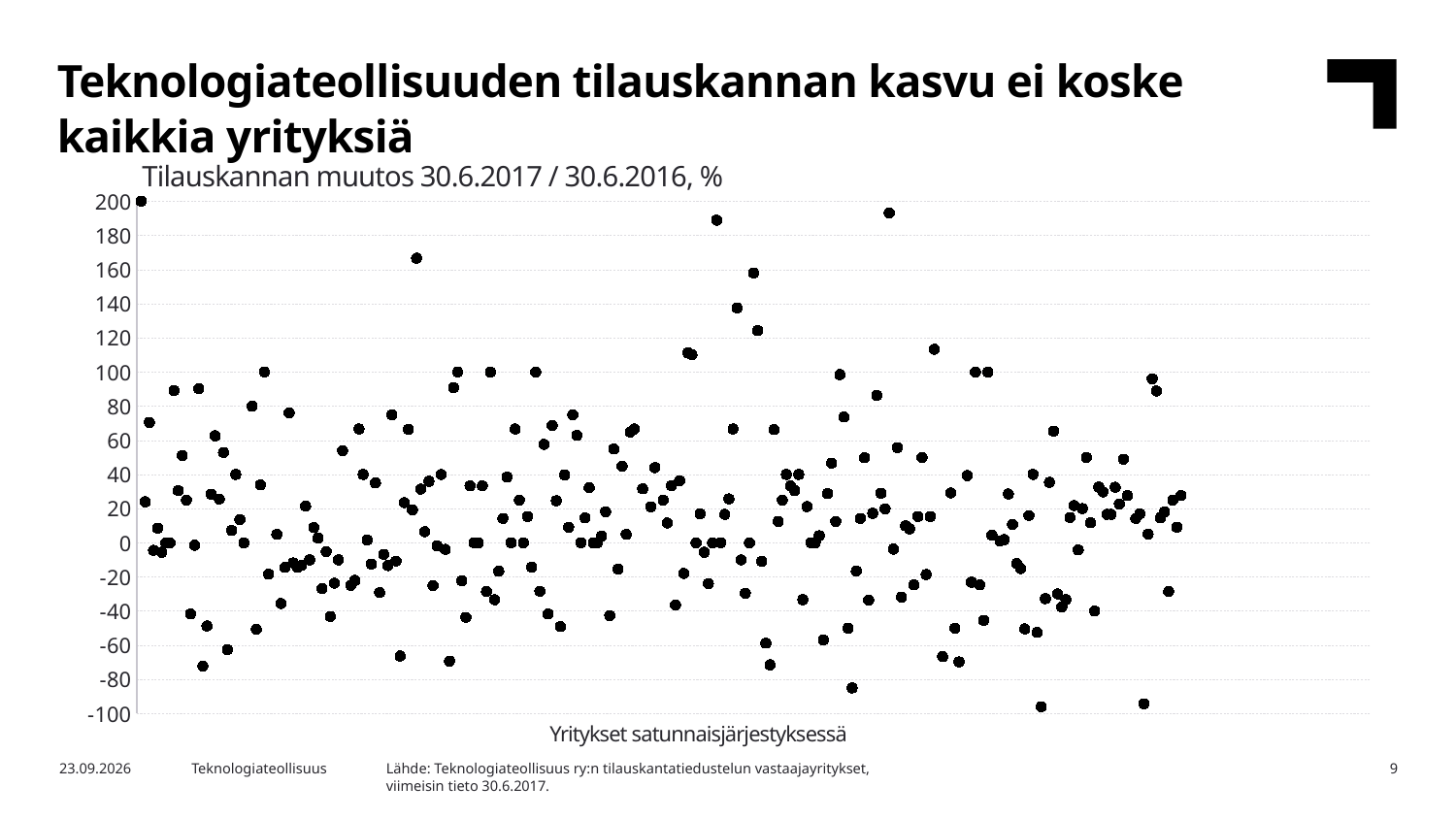
Is the highest plotted point on the chart greater or less than 100? greater Is the lowest plotted point on the chart greater or less than -80? less Is the highest plotted point on the chart greater or less than 180? greater What is the title of the chart? Tilauskannan muutos 30.6.2017 / 30.6.2016, % What kind of chart is shown on the slide? scatter chart What is the label of the x axis of the chart? Yritykset satunnaisjärjestyksessä